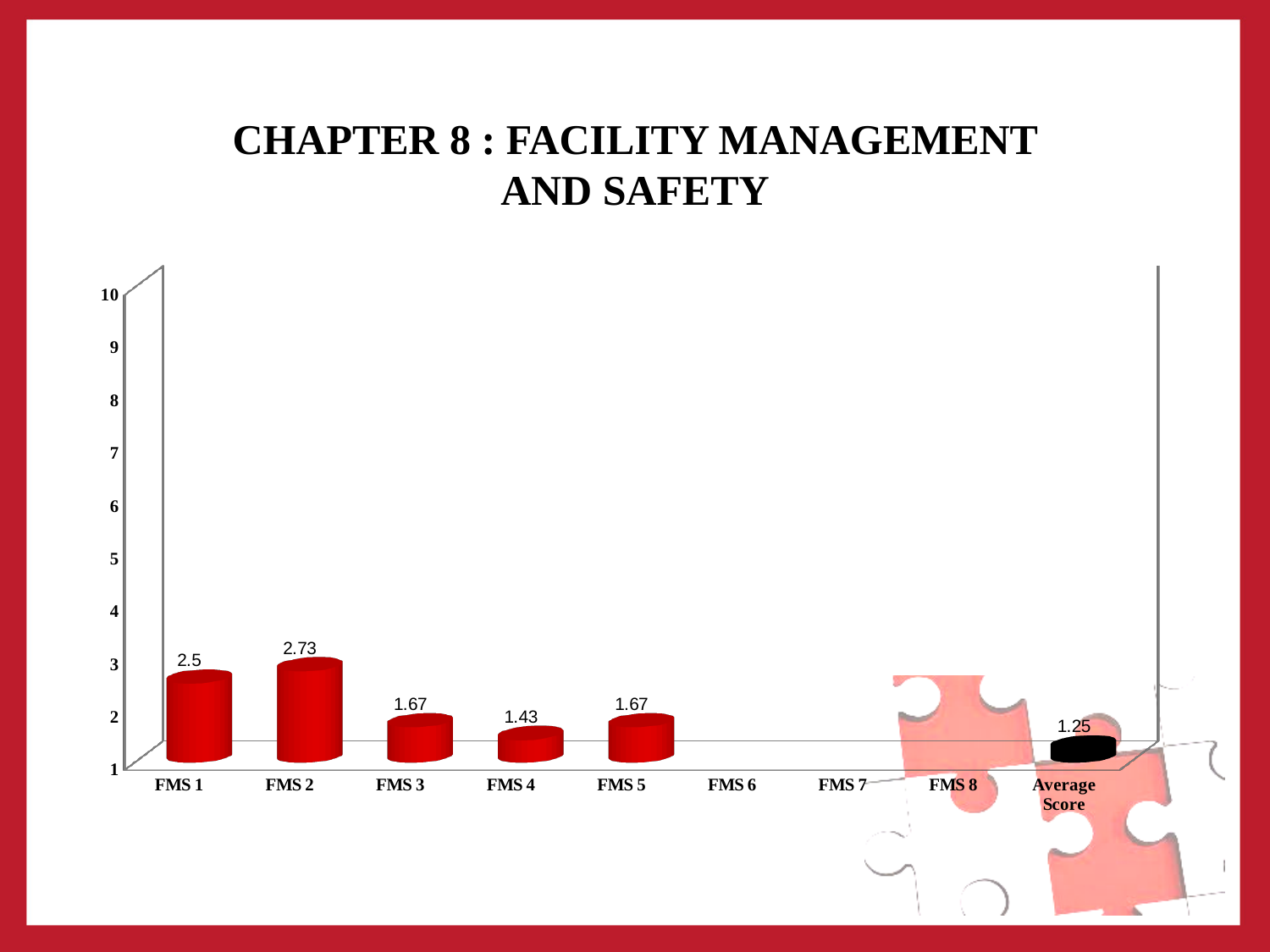
What is the value shown for Average Score? 1.25 Which category has the highest value? FMS 2 What kind of chart is shown on the slide? bar chart How many categories are labelled on the x axis? 9 Which is larger, the value for FMS 3 or the value for FMS 4? FMS 3 What is the title of the slide? CHAPTER 8 : FACILITY MANAGEMENT AND SAFETY What is the difference between the values for FMS 2 and FMS 1? 0.23 What is the value for FMS 1? 2.5 What is the value for FMS 2? 2.73 What is the value for FMS 4? 1.43 Among the bars plotted, which category has the lowest value? Average Score Is the value for FMS 2 greater or less than 3? less